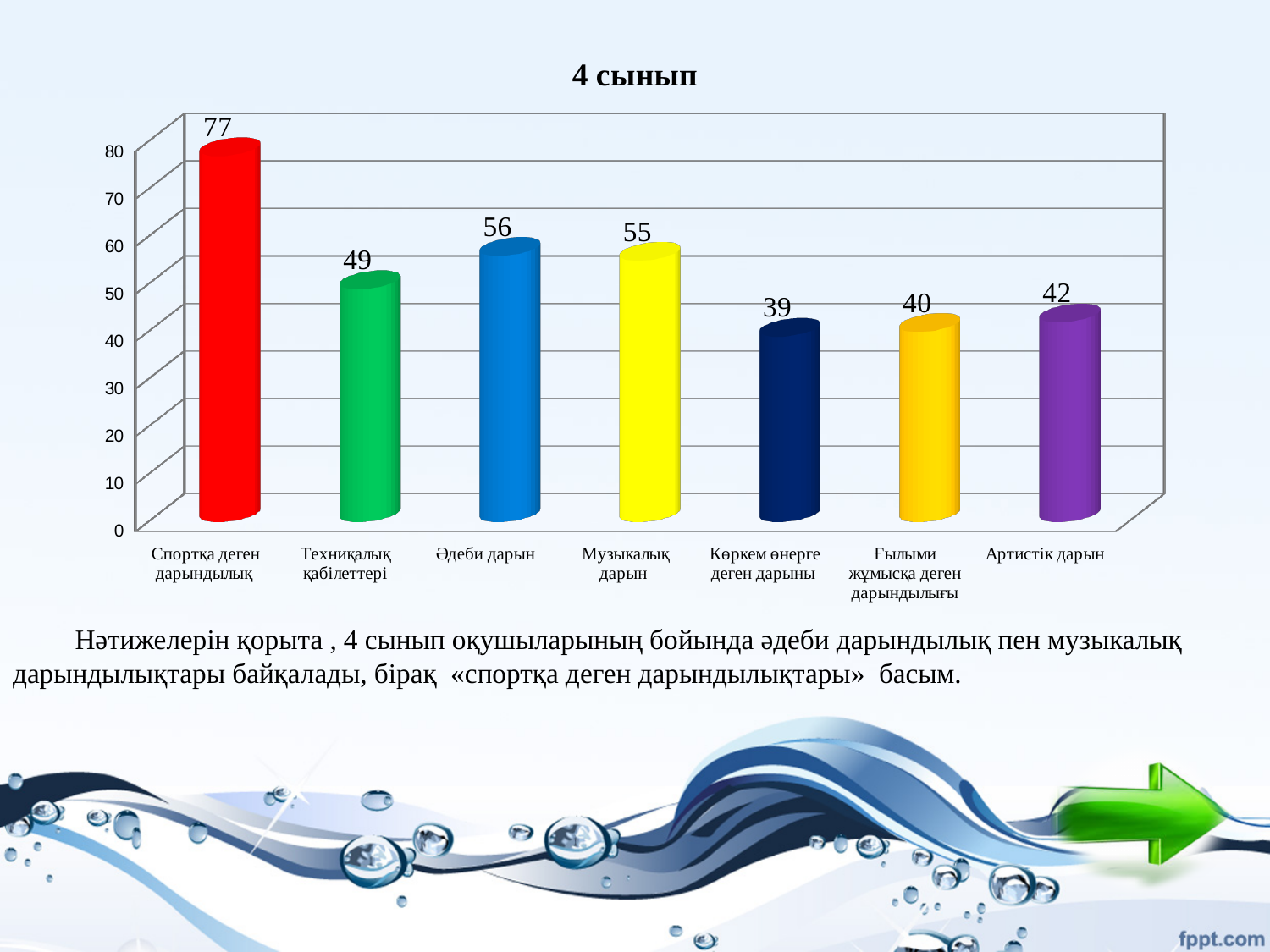
What is the value for Әдеби дарын? 56 What kind of chart is shown on the slide? bar chart Which category has the highest value? Спортқа деген дарындылық What is the value for Спортқа деген дарындылық? 77 What is the title of the chart? 4 сынып Which is larger, the value for Техниқалық қабілеттері or the value for Артистік дарын? Техниқалық қабілеттері What is the value for Ғылыми жұмысқа деген дарындылығы? 40 What is the difference between the values for Музыкалық дарын and Артистік дарын? 13 What is the difference between the values for Спортқа деген дарындылық and Техниқалық қабілеттері? 28 Is the value for Музыкалық дарын greater or less than 50? greater How many categories are shown on the chart? 7 Which category has the lowest value? Көркем өнерге деген дарыны